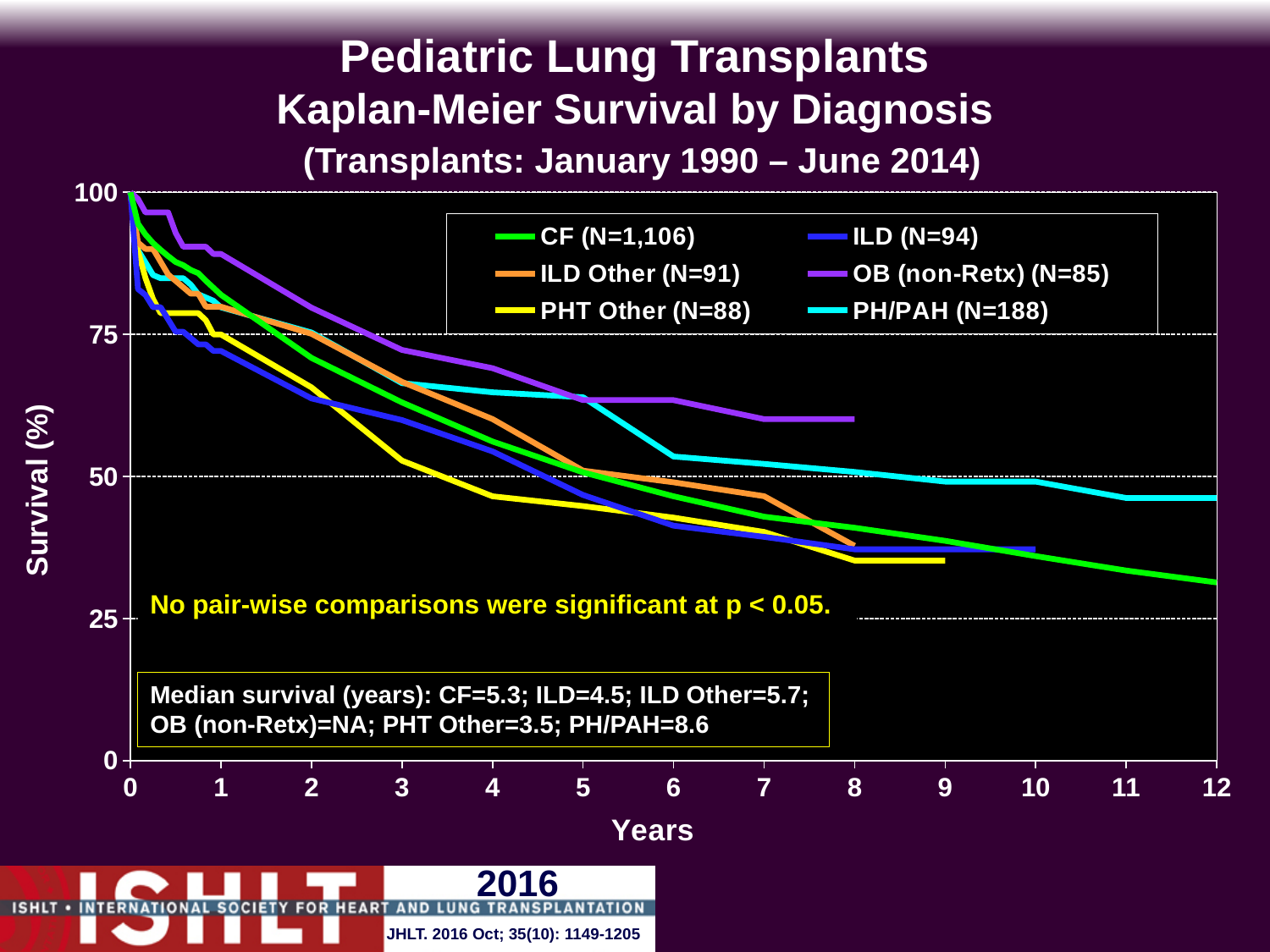
What is the median survival in years for PH/PAH according to the text box? 8.6 Do the survival curves rise or fall as years increase? Fall Is the survival value for PH/PAH at 12 years greater or less than 50? less Which diagnosis group has the lowest median survival listed in the text box? PHT Other What is the difference in median survival (years) between ILD Other and ILD? 1.2 What is the median survival in years for PHT Other according to the text box? 3.5 How many series does the legend list? 6 At 6 years, which curve is higher: OB (non-Retx) or PHT Other? OB (non-Retx) Is the survival value for CF at 12 years greater or less than 25? greater What is the N for the CF group shown in the legend? N=1,106 Among the groups with a numeric median survival in the text box, which has the highest value? PH/PAH What kind of chart is shown on the slide? Line chart